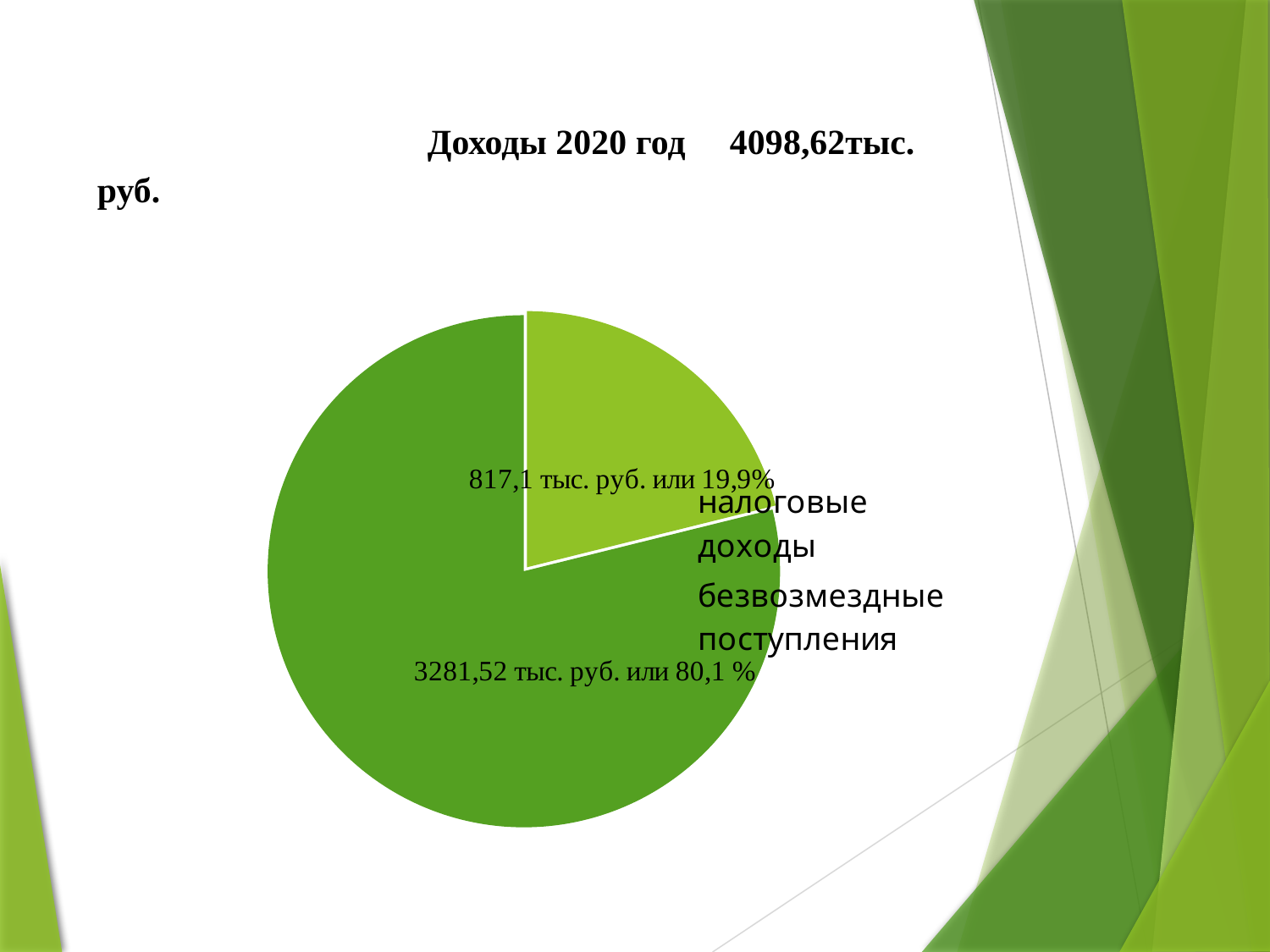
What total amount is stated in the chart title for Доходы 2020 год? 4098,62тыс. руб. How many slices does the pie chart have? 2 What share of the pie does "безвозмездные поступления" represent? 80,1 % What share of the pie does "налоговые доходы" represent? 19,9% How many entries does the legend of the pie chart list? 2 Which category has the largest slice of the pie? безвозмездные поступления What is the difference in percentage points between the shares of "безвозмездные поступления" and "налоговые доходы"? 60,2 Which category has the smallest slice of the pie? налоговые доходы What kind of chart is shown on the slide? pie chart What is the value in тыс. руб. for "безвозмездные поступления"? 3281,52 тыс. руб. Which is larger, "налоговые доходы" or "безвозмездные поступления"? безвозмездные поступления What is the value in тыс. руб. for "налоговые доходы"? 817,1 тыс. руб.